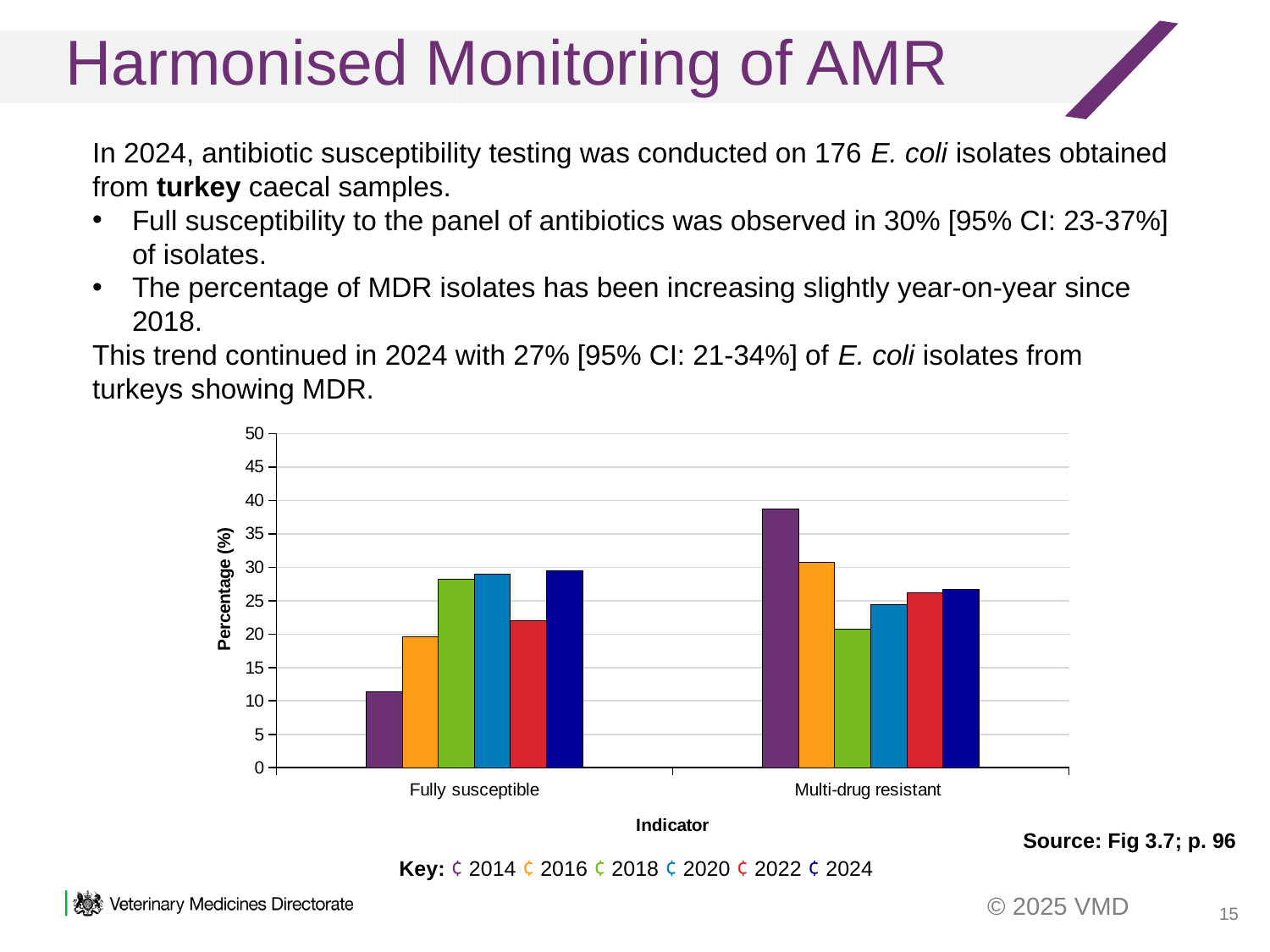
Is the 2014 value for Multi-drug resistant greater or less than 35? greater How many years (series) does the key list for the chart? 6 How many indicator categories are shown on the x axis of the chart? 2 For 2014, which is larger: the Fully susceptible bar or the Multi-drug resistant bar? Multi-drug resistant What is the label on the y axis of the chart? Percentage (%) Which year has the lowest bar in the Multi-drug resistant group? 2018 In the Multi-drug resistant group, do the bars rise or fall from 2018 to 2024? rise Which year has the lowest bar in the Fully susceptible group? 2014 Which year has the highest bar in the Multi-drug resistant group? 2014 Is the 2014 value for Fully susceptible greater or less than 15? less Is the 2022 value for Fully susceptible greater or less than 25? less What kind of chart is shown on the slide? bar chart